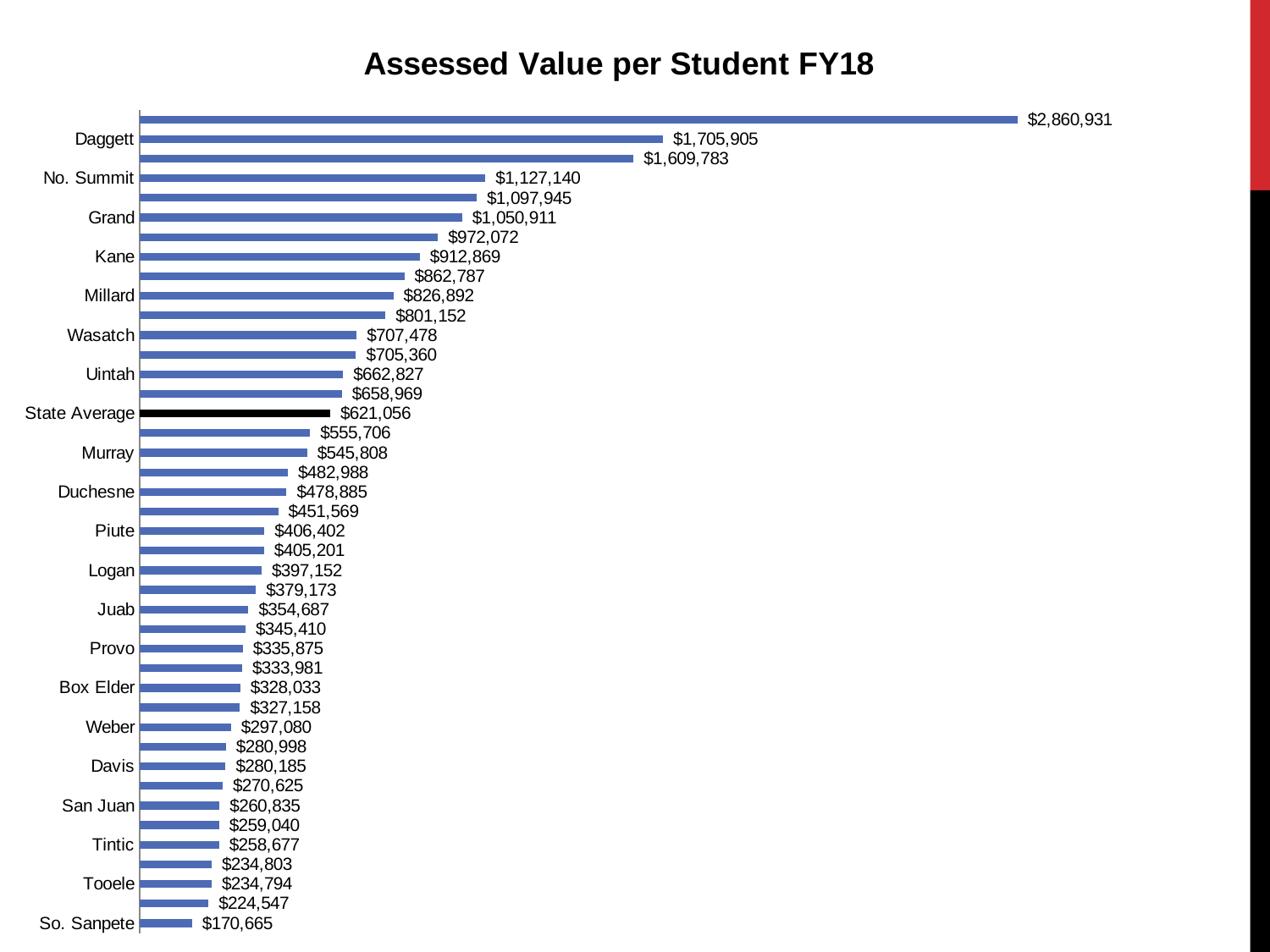
How many bars are plotted on the chart? 42 Which bar is drawn in black instead of blue? State Average Which labeled district has the lowest assessed value per student? So. Sanpete What is the assessed value per student for the State Average? $621,056 What kind of chart is shown on the slide? Bar chart What is the assessed value per student for Provo? $335,875 What is the assessed value per student for Daggett? $1,705,905 How much higher is the State Average than Murray's assessed value per student? $75,248 Which has a higher assessed value per student, Kane or Millard? Kane What is the largest assessed value per student shown on the chart? $2,860,931 What is the assessed value per student for So. Sanpete? $170,665 Do the bar values increase or decrease from the top of the chart to the bottom? Decrease